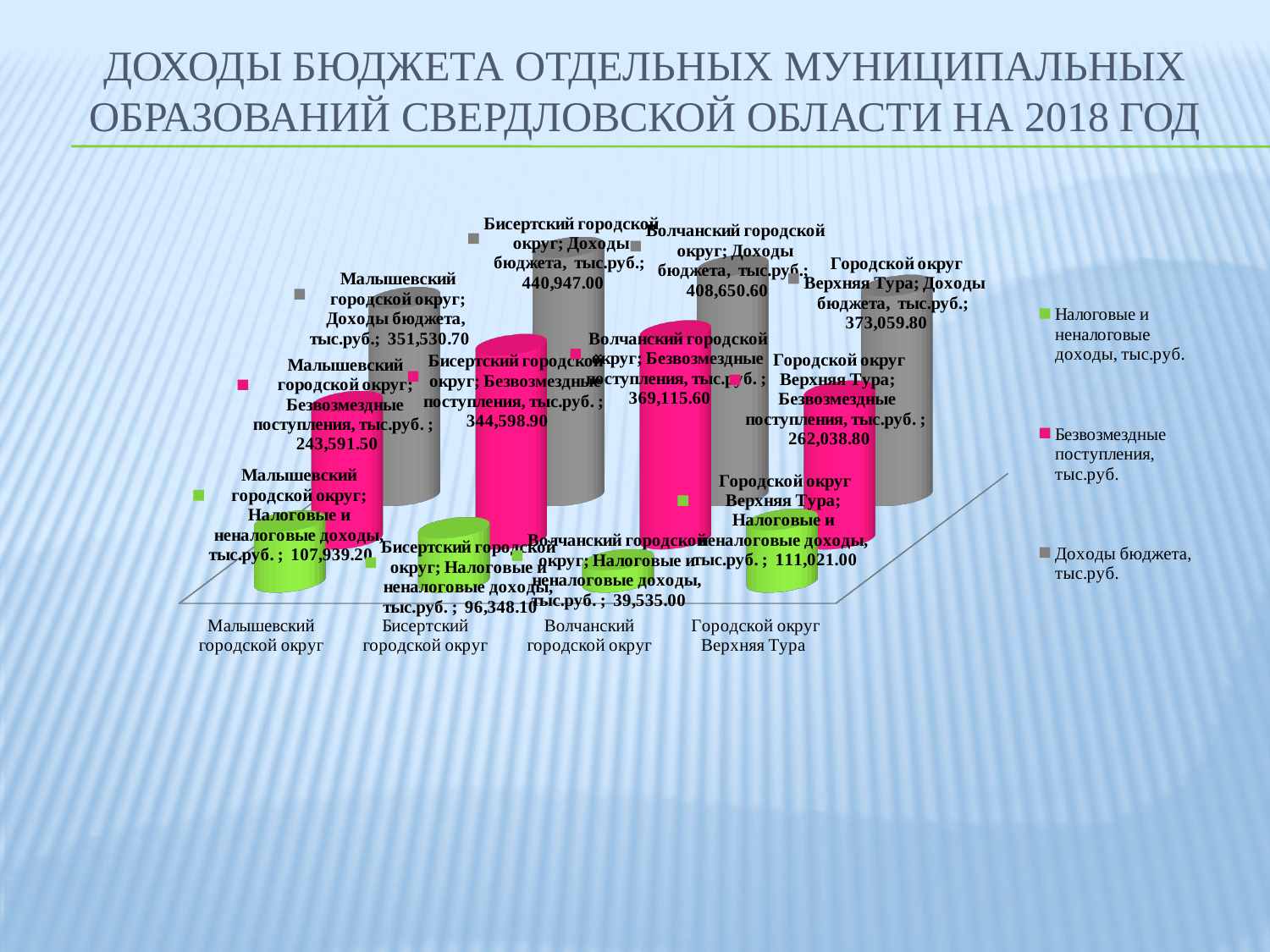
Сколько рядов данных перечислено в легенде диаграммы? 3 Каким цветом на диаграмме обозначен ряд «Доходы бюджета, тыс.руб.»? Серым У какого муниципального образования наибольшее значение показателя «Доходы бюджета, тыс.руб.»? Бисертский городской округ На сколько доходы бюджета Волчанского городского округа больше доходов бюджета Малышевского городского округа (тыс.руб.)? 57,119.90 Какого типа диаграмма представлена на слайде? Столбчатая (bar chart) Какое значение показателя «Безвозмездные поступления, тыс.руб.» указано для Малышевского городского округа? 243,591.50 Сколько муниципальных образований представлено на диаграмме? 4 У какого муниципального образования наименьшее значение показателя «Налоговые и неналоговые доходы, тыс.руб.»? Волчанский городской округ Что больше: безвозмездные поступления Волчанского городского округа или Бисертского городского округа? Волчанского городского округа Какое значение показателя «Безвозмездные поступления, тыс.руб.» указано для Городского округа Верхняя Тура? 262,038.80 Какое значение показателя «Доходы бюджета, тыс.руб.» указано для Бисертского городского округа? 440,947.00 Какое значение показателя «Налоговые и неналоговые доходы, тыс.руб.» указано для Волчанского городского округа? 39,535.00